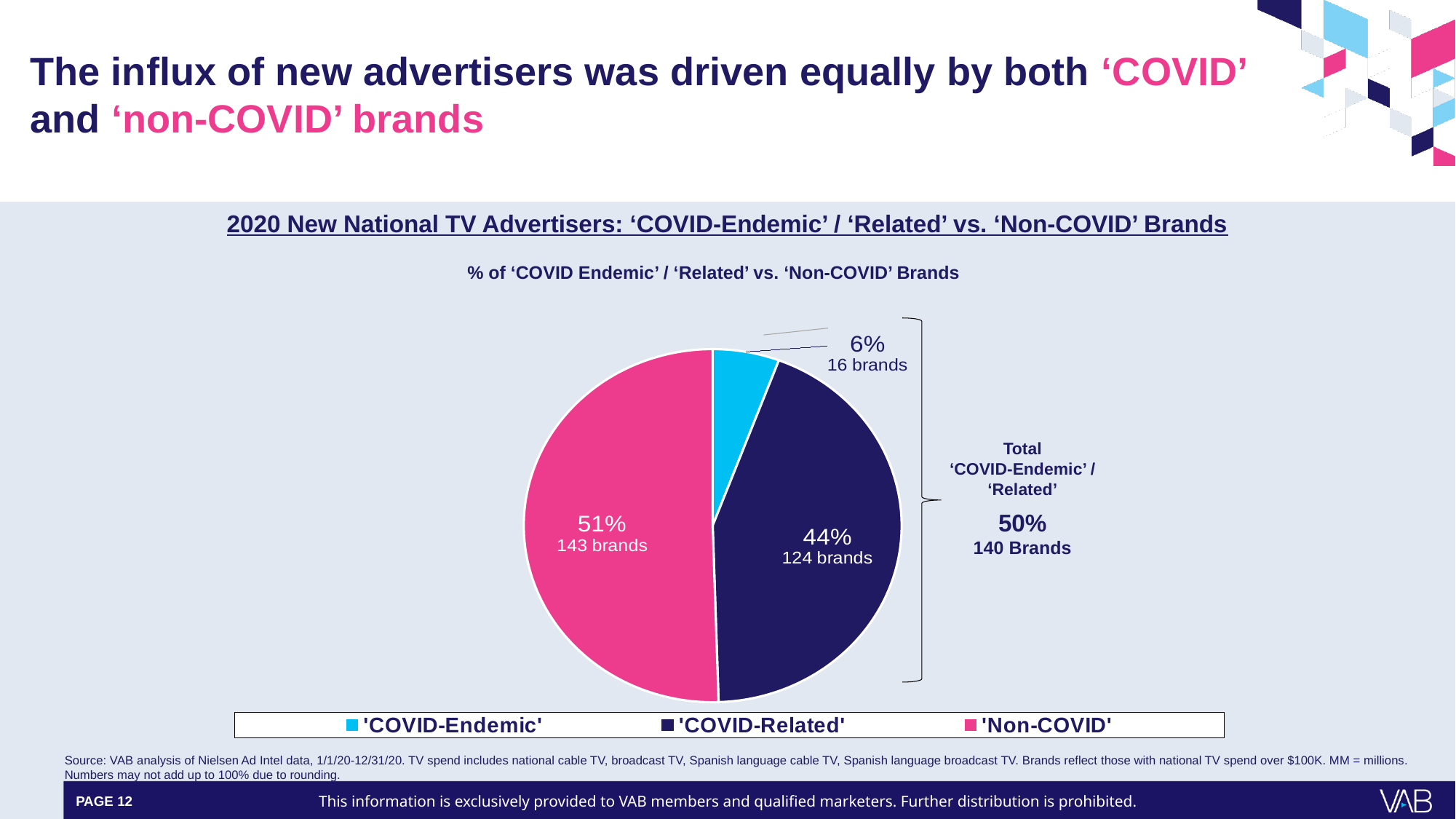
Which category has the smallest slice of the pie? 'COVID-Endemic' What colour is the 'COVID-Endemic' slice? light blue What kind of chart is shown on the slide? pie chart How many categories does the legend list? 3 What percentage of the pie is 'COVID-Endemic' brands? 6% How many brands are 'COVID-Related'? 124 brands How many more brands are 'Non-COVID' than 'COVID-Related'? 19 brands What share of the pie is 'Non-COVID' brands? 51% How many brands are 'Non-COVID'? 143 brands Which category has the largest slice of the pie? 'Non-COVID' What is the combined total of 'COVID-Endemic' and 'COVID-Related' brands shown by the bracket? 140 Brands Which has more brands, 'COVID-Endemic' or 'COVID-Related'? 'COVID-Related'